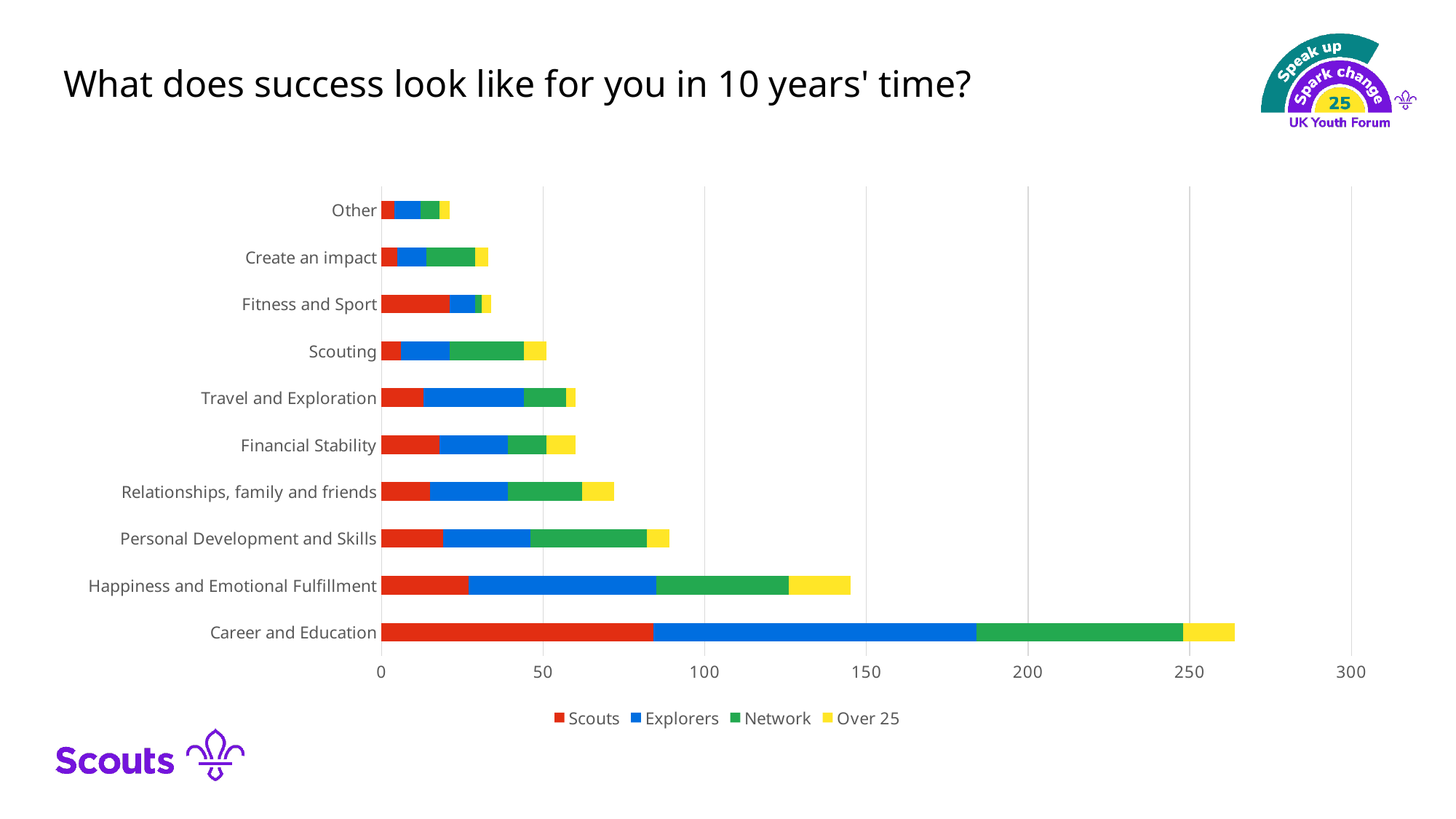
How many series does the legend list? 4 Is the total value for Career and Education greater or less than 250? greater Is the total value for Relationships, family and friends greater or less than 50? greater Which has the larger total value, Happiness and Emotional Fulfillment or Personal Development and Skills? Happiness and Emotional Fulfillment Which category has the lowest total value? Other What kind of chart is shown on the slide? Stacked bar chart Is the total value for Personal Development and Skills greater or less than 100? less Which series is shown in yellow in the legend? Over 25 Which category has the highest total value? Career and Education What is the title of the chart? What does success look like for you in 10 years' time? How many categories are plotted on the chart? 10